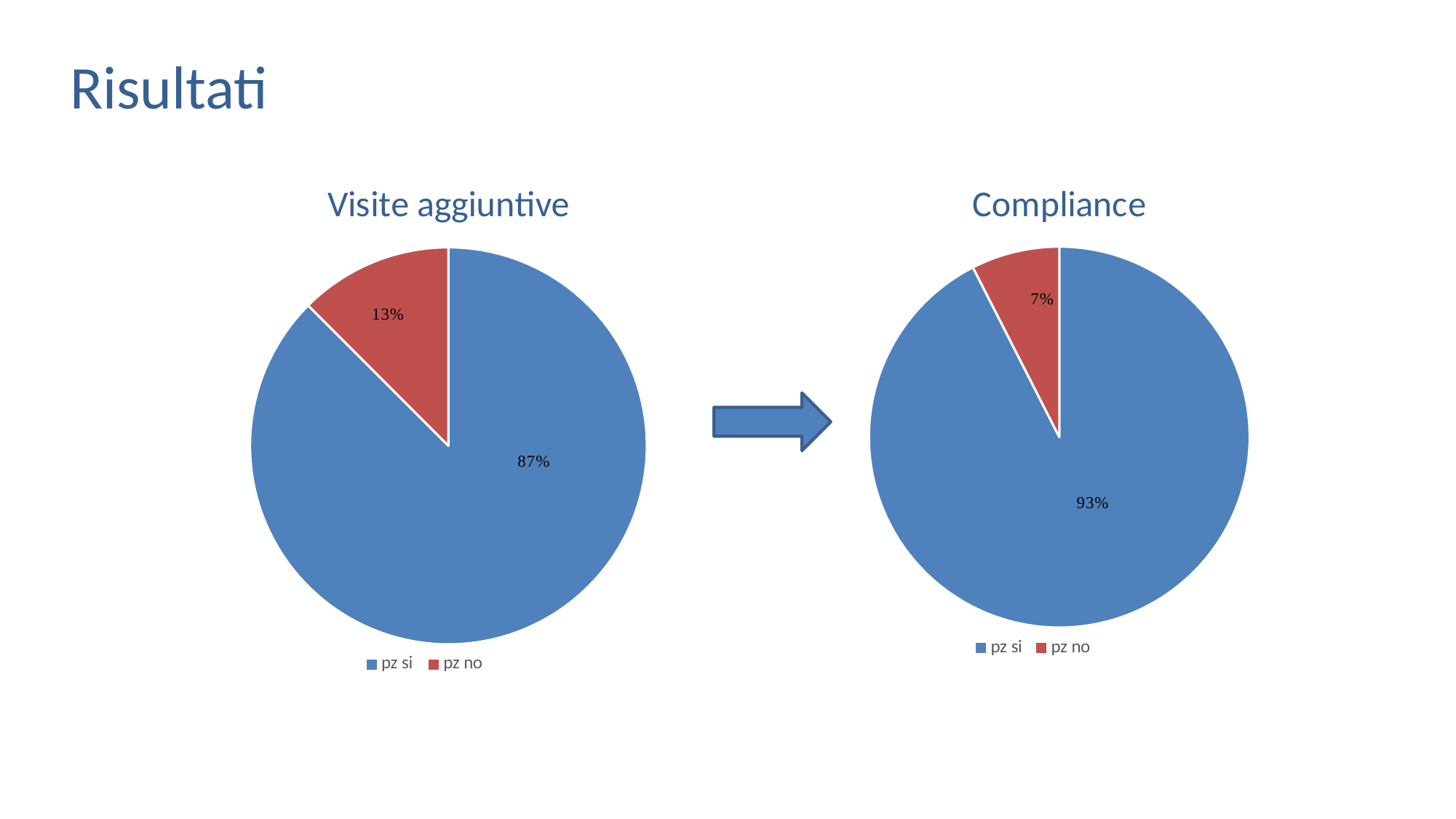
How many slices does the "Visite aggiuntive" pie chart have? 2 In the "Visite aggiuntive" chart, what is the difference between the pz si and pz no shares? 74% In the "Visite aggiuntive" chart, what is the value for pz no? 13% In the "Compliance" chart, which category has the smallest slice? pz no What type of chart is the "Compliance" chart? Pie chart In the "Compliance" chart, what is the difference between the pz si and pz no shares? 86% In the "Visite aggiuntive" chart, what is the value for pz si? 87% In the "Visite aggiuntive" chart, which category has the largest slice? pz si In the "Compliance" chart, what colour is the pz no slice? Red Is the pz no slice larger in the "Visite aggiuntive" chart or in the "Compliance" chart? Visite aggiuntive In the "Compliance" chart, what is the value for pz no? 7% In the "Compliance" chart, what is the value for pz si? 93%